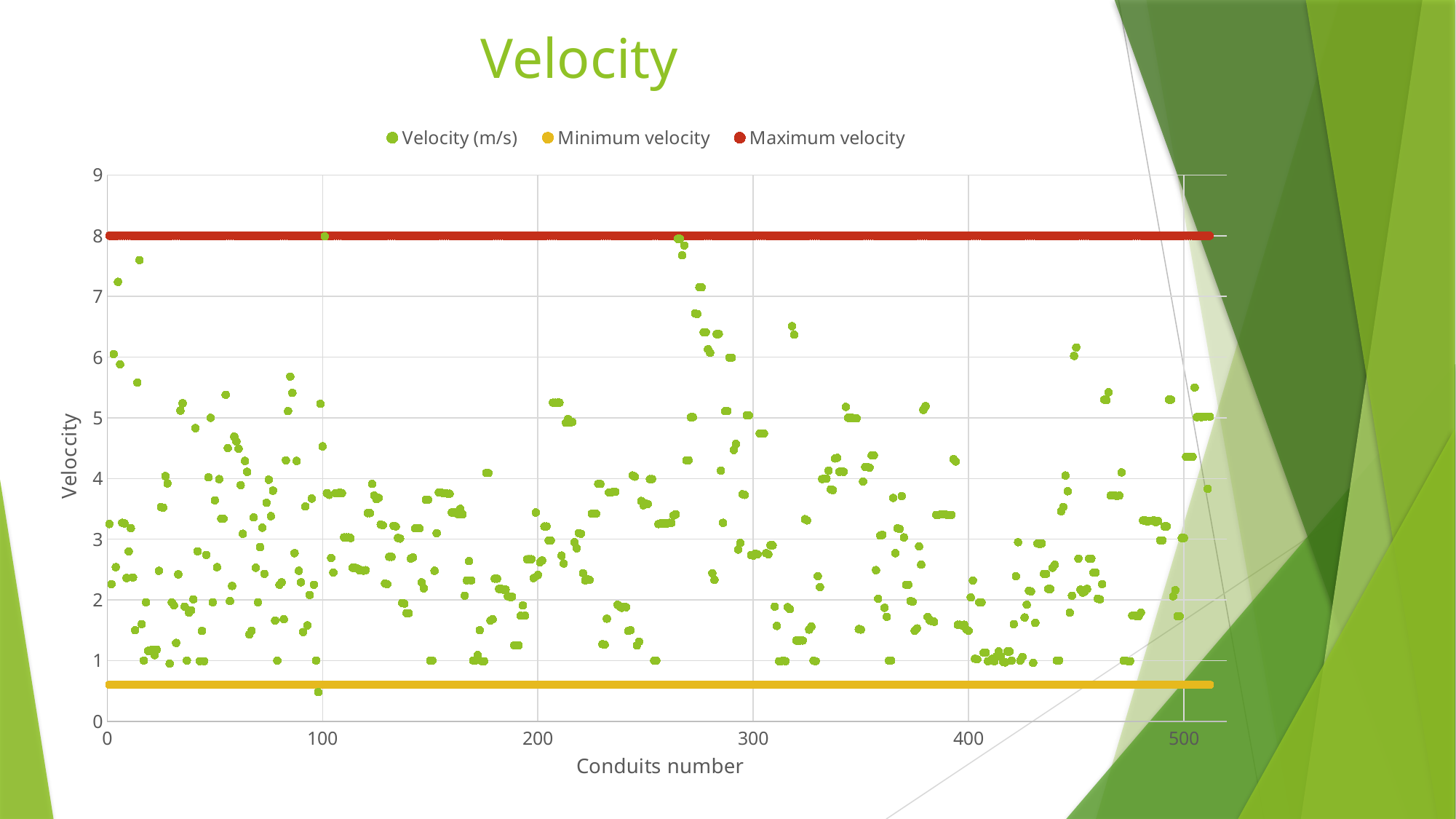
What is the label of the x axis? Conduits number Is the value of the Minimum velocity series greater or less than 1? less Is the lowest Velocity (m/s) point greater or less than 1? less How many series does the legend list? 3 Is the highest Velocity (m/s) point greater or less than 7? greater What value does the Maximum velocity series sit at? 8 Which series has the larger value, Maximum velocity or Minimum velocity? Maximum velocity What kind of chart is shown on the slide? Scatter chart What is the title of the chart? Velocity Does the Maximum velocity series rise, fall, or stay constant along the x axis? stay constant What is the highest value shown on the y axis? 9